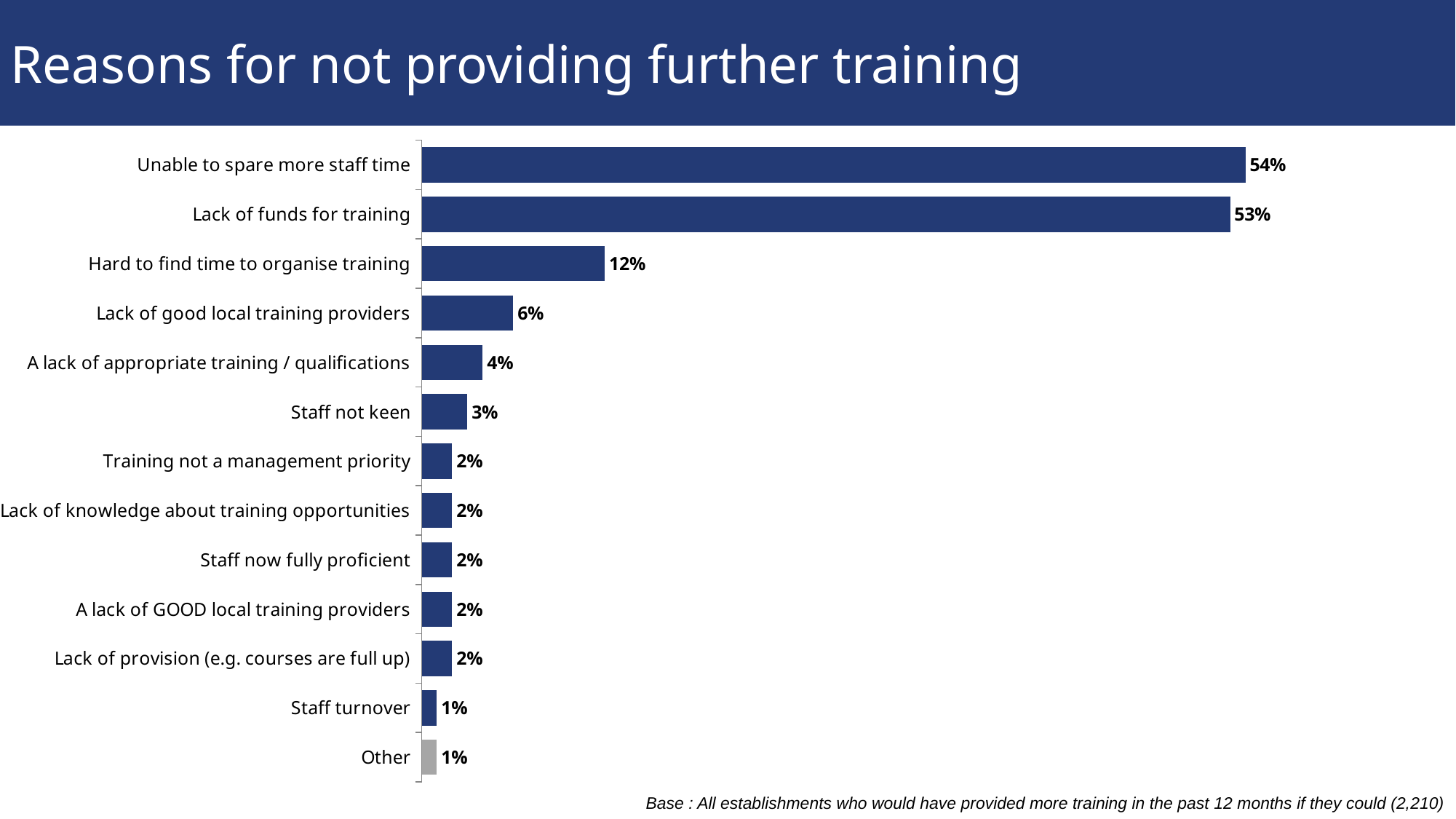
What is the value for "Staff turnover"? 1% What is the title of the slide? Reasons for not providing further training What is the value for "Lack of funds for training"? 53% Which reason has the highest value? Unable to spare more staff time What is the difference between "Lack of good local training providers" and "A lack of appropriate training / qualifications"? 2 percentage points What is the value for "Staff not keen"? 3% What kind of chart is shown on the slide? Bar chart What is the value for "Hard to find time to organise training"? 12% Which is larger: "Hard to find time to organise training" or "Lack of good local training providers"? Hard to find time to organise training How many reasons (categories) are plotted in the chart? 13 What is the difference between "Unable to spare more staff time" and "Hard to find time to organise training"? 42 percentage points What is the value for "Unable to spare more staff time"? 54%